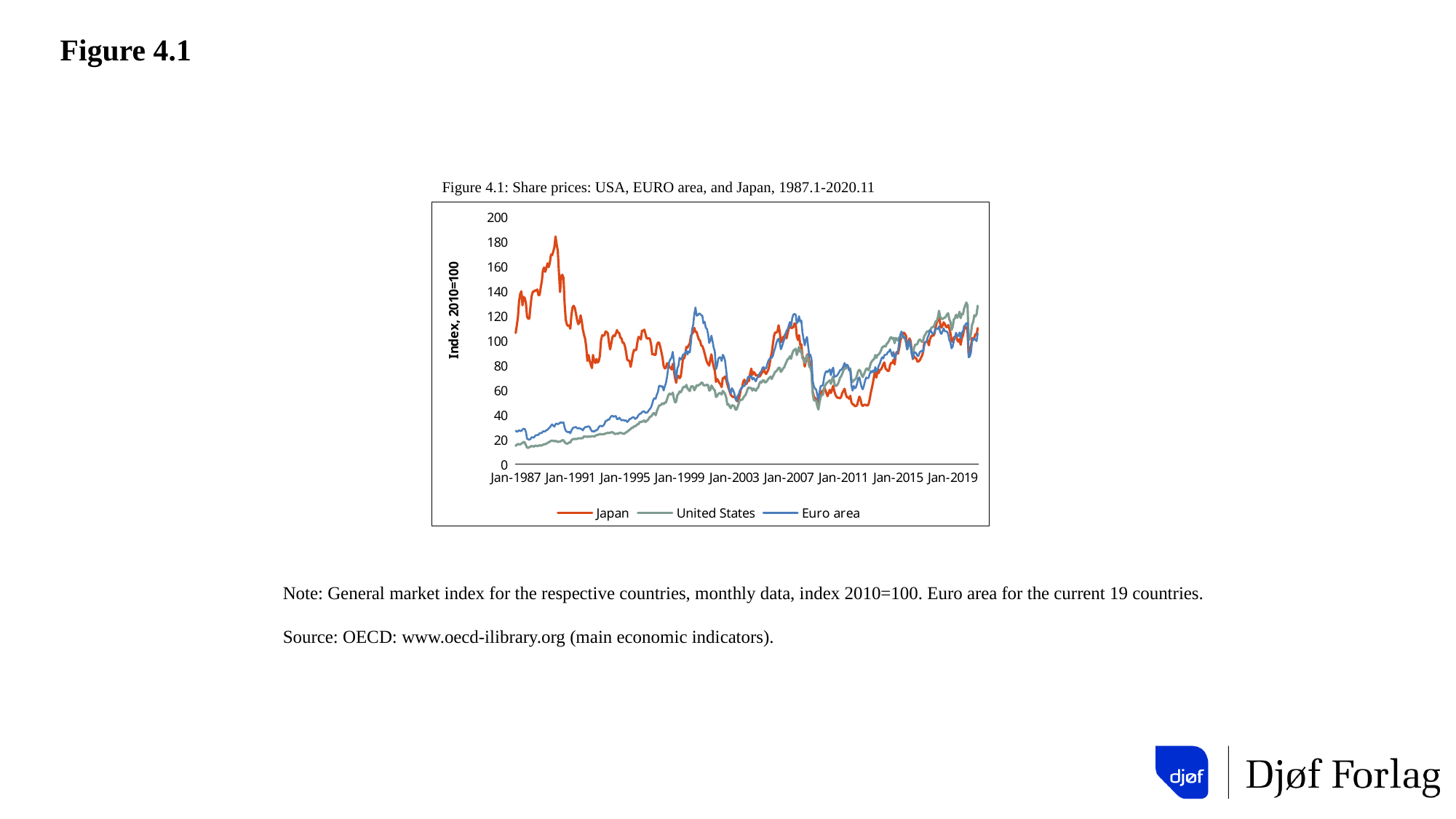
How many series does the legend list? 3 In Jan-1995, which is larger: the value for Japan or the value for the United States? Japan What kind of chart is shown on the slide? Line chart Is the peak value of the Japan series around 1990 greater or less than 160? greater Is the value for the Euro area in Jan-1987 greater or less than 60? less Does the United States series generally rise or fall from Jan-1987 to Jan-2019? Rise Which series are listed in the chart legend? Japan, United States, Euro area What is the label on the vertical axis of the chart? Index, 2010=100 Which series has the lowest value in Jan-1987? United States Which series has the highest value in Jan-1991? Japan How many year labels are shown on the horizontal axis? 9 Is the value for the United States in Jan-1987 greater or less than 40? less